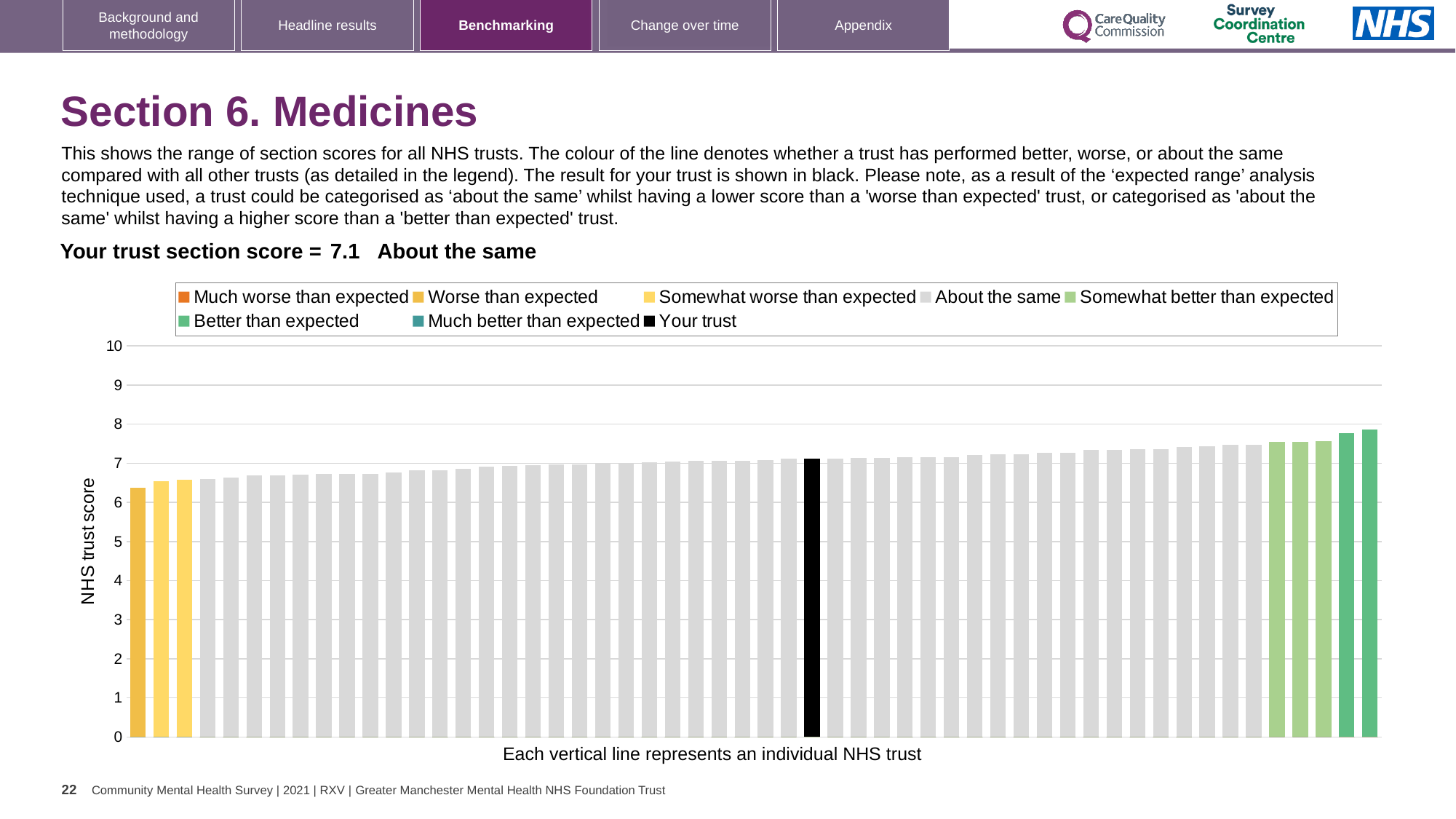
Is the value for the highest bar greater or less than 8? less What is the highest value shown on the vertical axis? 10 Is the value for the lowest bar greater or less than 7? less What is the section score for your trust shown on the slide? 7.1 How many entries does the chart legend list? 8 Is the value for the highest bar greater or less than 7? greater What colour is the bar representing your trust? black What kind of chart is shown on the slide? bar chart What is the label on the vertical axis of the chart? NHS trust score Do the bar values rise or fall from left to right along the x axis? rise Which category is your trust placed in for this section? About the same